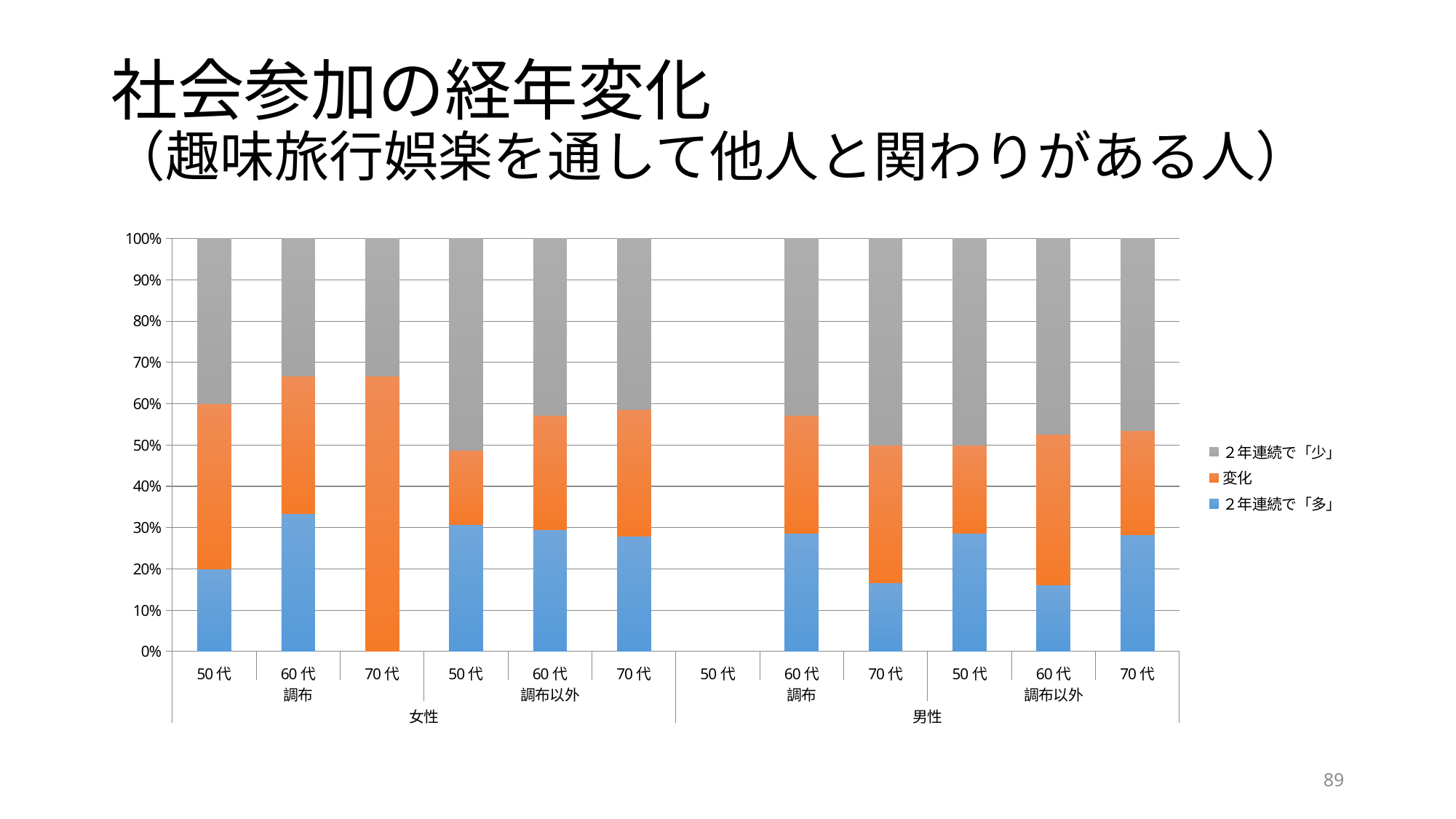
What are the three legend entries of the chart? ２年連続で「少」, 変化, ２年連続で「多」 What kind of chart is shown on the slide? Stacked bar chart Is the ２年連続で「多」 value for 男性 調布 70代 greater or less than 20%? less Which bar has no ２年連続で「多」 segment at all? 女性 調布 70代 Is the ２年連続で「多」 value for 女性 調布 60代 greater or less than 30%? greater Is the ２年連続で「多」 value for 男性 調布以外 60代 greater or less than 20%? less Which category has no bar drawn at all? 男性 調布 50代 Which has the larger ２年連続で「少」 share: 女性 調布以外 50代 or 女性 調布 70代? 女性 調布以外 50代 How many series does the legend list? 3 Which has the larger ２年連続で「多」 share: 女性 調布 60代 or 男性 調布 70代? 女性 調布 60代